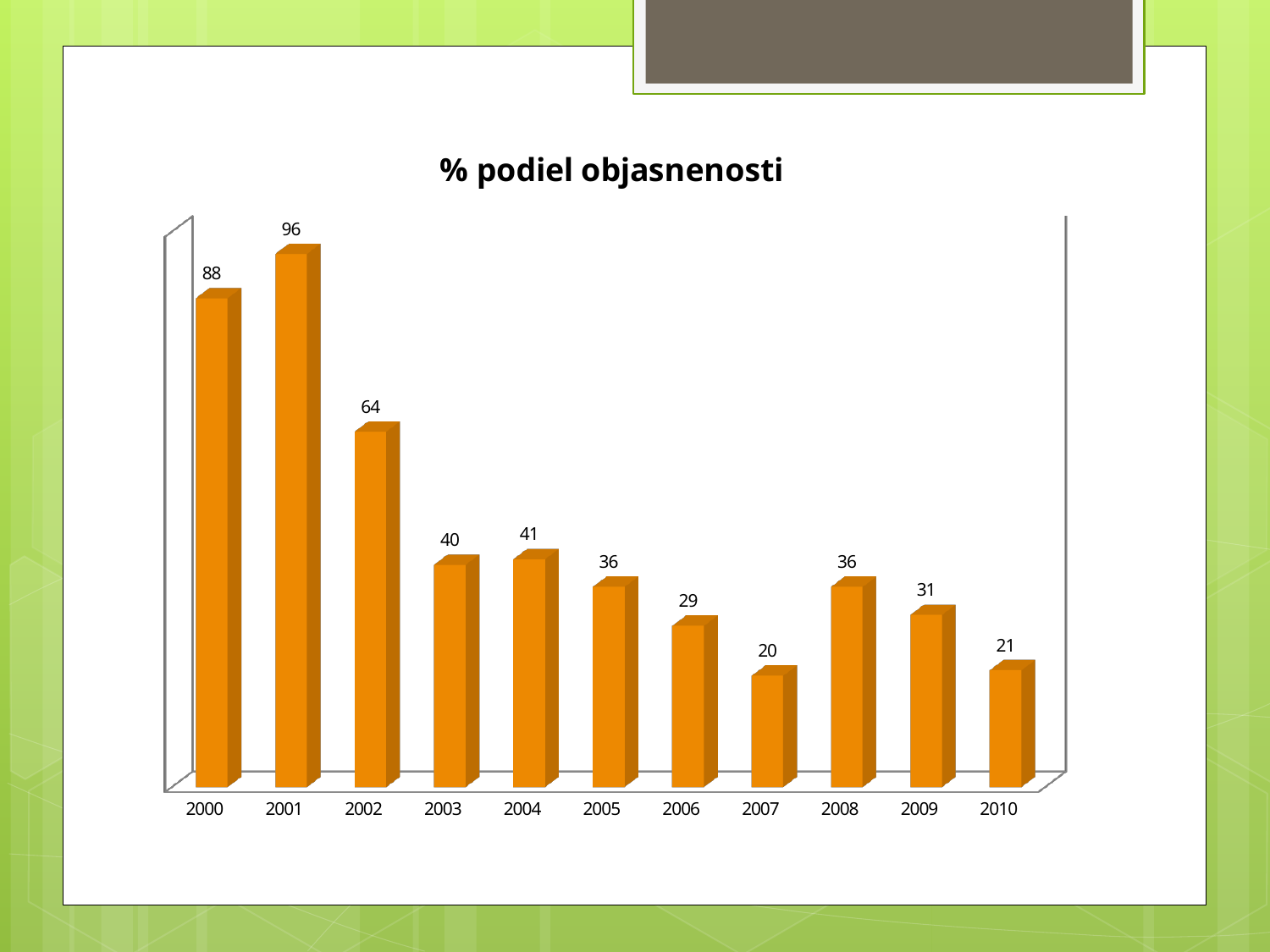
What is the title of the chart? % podiel objasnenosti What is the difference between the values for 2000 and 2002? 24 What is the difference between the values for 2008 and 2009? 5 What is the value for 2007? 20 How many years are shown on the x axis? 11 Which year has the highest value? 2001 What kind of chart is this? bar chart What is the value for 2010? 21 Do the values generally rise or fall from 2000 to 2010? fall What is the value for 2001? 96 Which year has the lowest value? 2007 Which is larger, the value for 2003 or the value for 2006? 2003